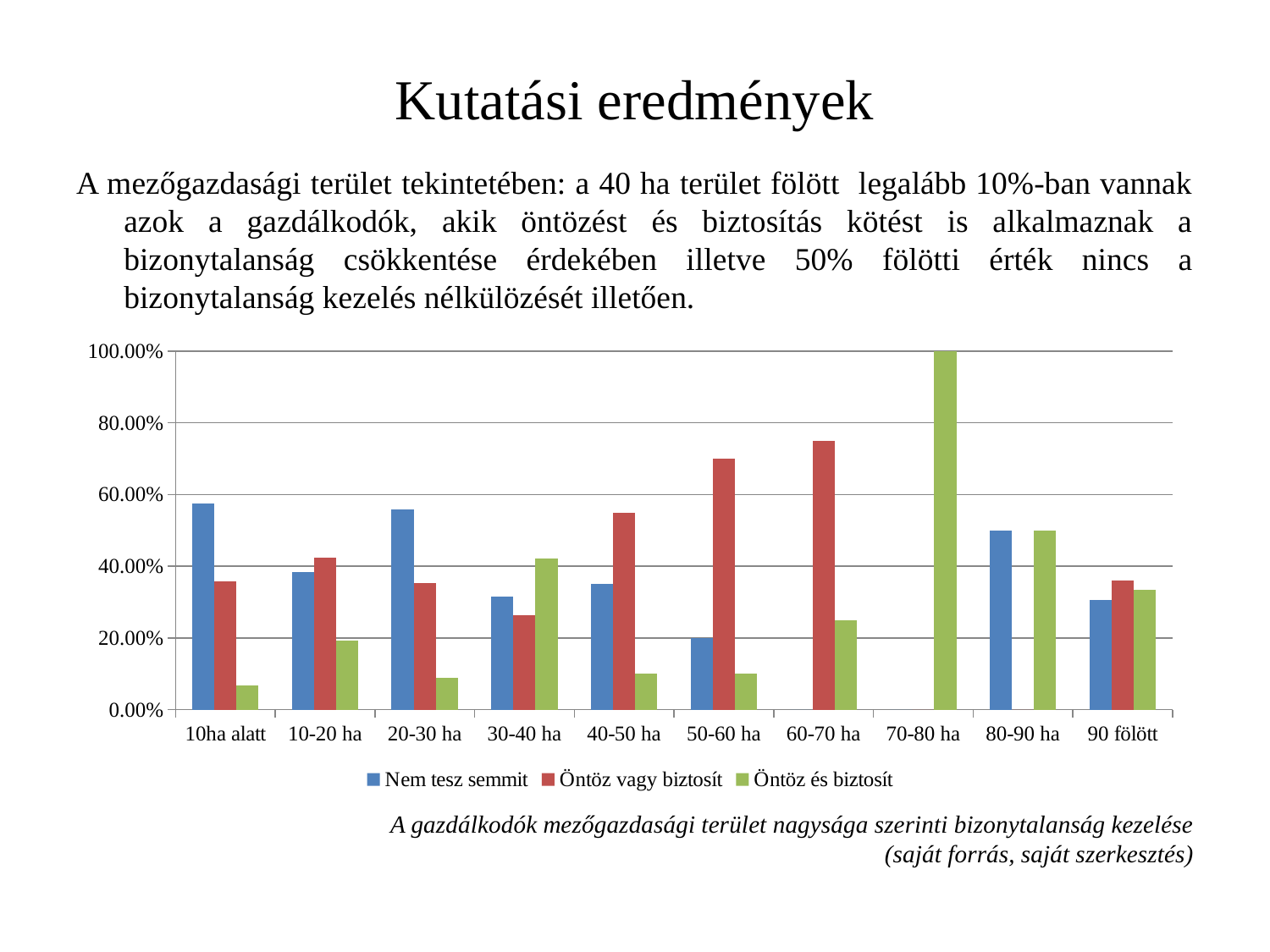
How many area categories are shown on the x axis of the chart? 10 Is the value of 'Nem tesz semmit' for 80-90 ha greater or less than 40.00%? greater What kind of chart is shown on the slide? bar chart Which category has the highest value for 'Öntöz és biztosít'? 70-80 ha Which category has the highest value for 'Öntöz vagy biztosít'? 60-70 ha For the 40-50 ha category, which is larger: 'Öntöz vagy biztosít' or 'Nem tesz semmit'? Öntöz vagy biztosít Is the value of 'Nem tesz semmit' for '10ha alatt' greater or less than 40.00%? greater Is the value of 'Öntöz vagy biztosít' for 50-60 ha greater or less than 60.00%? greater For the 20-30 ha category, which is larger: 'Nem tesz semmit' or 'Öntöz vagy biztosít'? Nem tesz semmit How many series does the legend of the chart list? 3 What is the value of 'Öntöz és biztosít' for the 70-80 ha category? 100.00% What colour represents the 'Öntöz és biztosít' series in the chart? green